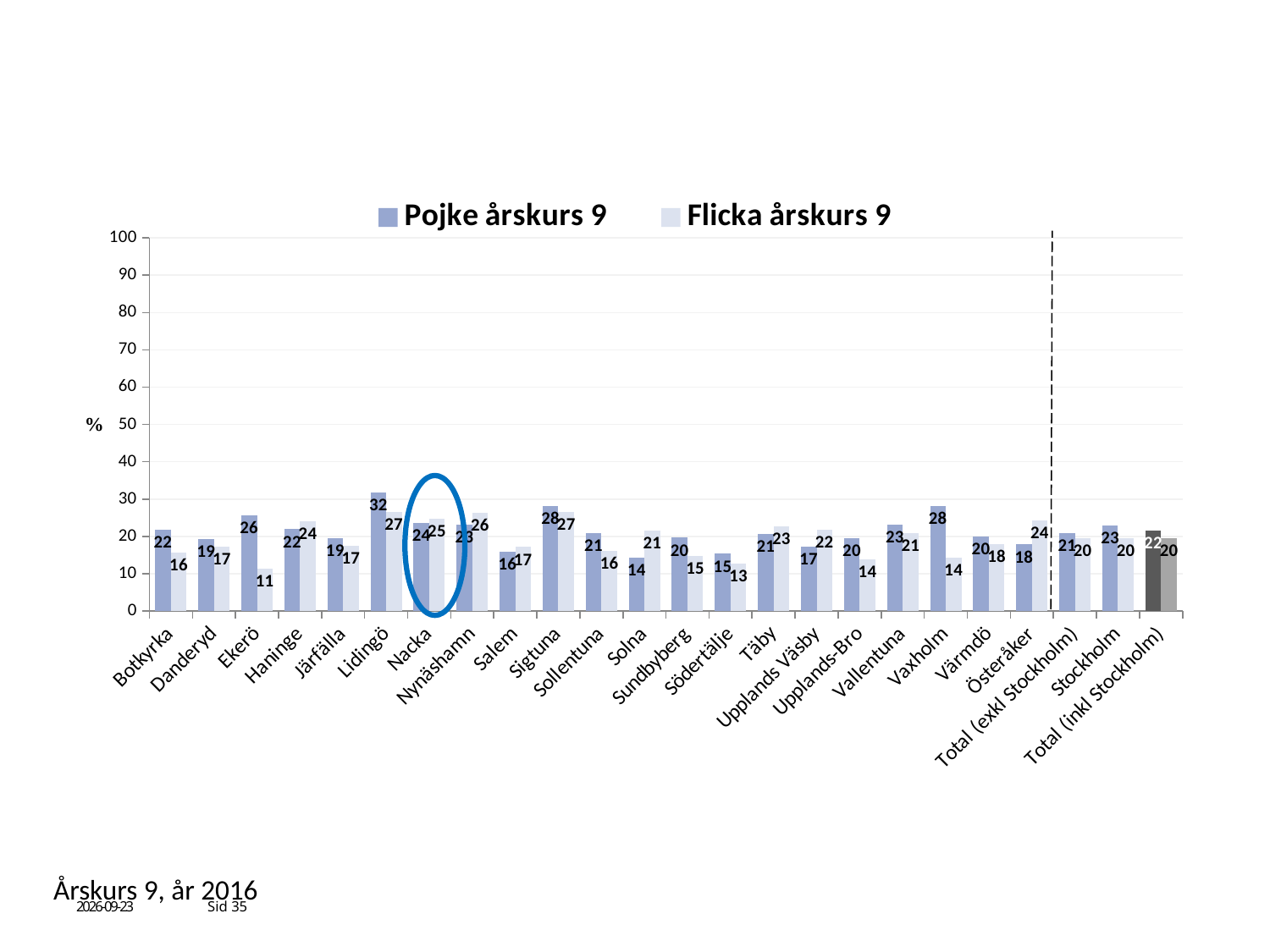
What is the value for Flicka årskurs 9 in Nacka? 25 What is the difference between the Pojke årskurs 9 and Flicka årskurs 9 values in Vaxholm? 14 What is the value for Flicka årskurs 9 in Ekerö? 11 Which municipality has the lowest value for Flicka årskurs 9? Ekerö Which is larger in Solna: the Pojke årskurs 9 value or the Flicka årskurs 9 value? Flicka årskurs 9 What kind of chart is shown on the slide? Bar chart Which municipality has the lowest value for Pojke årskurs 9? Solna Which municipality has the highest value for Pojke årskurs 9? Lidingö How many series does the legend list? 2 What is the value for Pojke årskurs 9 for Total (inkl Stockholm)? 22 Which municipality is circled on the chart? Nacka What is the value for Pojke årskurs 9 in Lidingö? 32